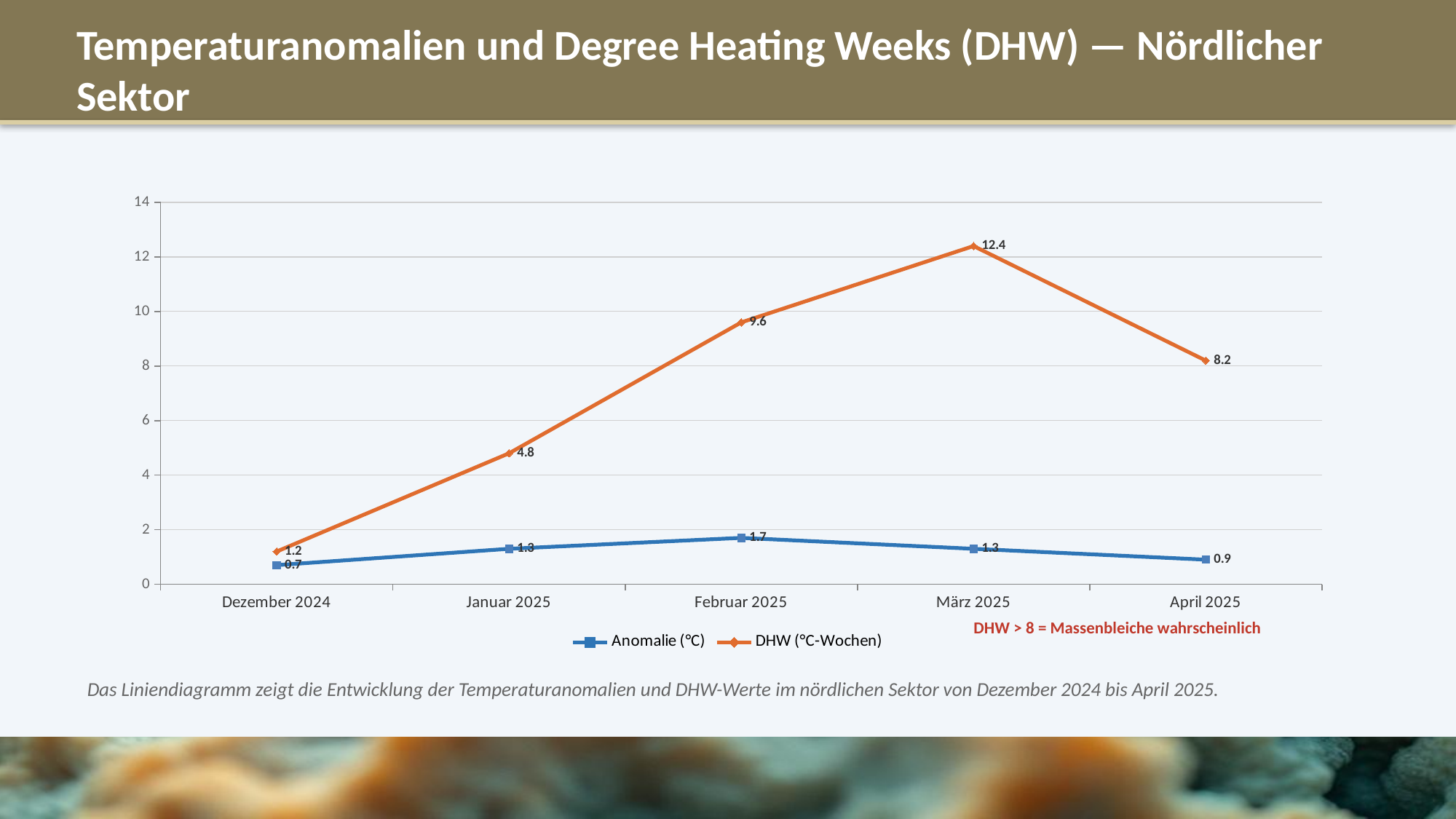
Is the DHW (°C-Wochen) value for April 2025 greater or less than 8? greater Which is larger: the DHW (°C-Wochen) value for Januar 2025 or for Februar 2025? Februar 2025 How many series does the legend list? 2 What is the DHW (°C-Wochen) value for Dezember 2024? 1.2 How many months are shown on the x axis? 5 What is the DHW (°C-Wochen) value for März 2025? 12.4 In which month is the Anomalie (°C) value lowest? Dezember 2024 What kind of chart is shown on the slide? Line chart In which month does the DHW (°C-Wochen) series reach its highest value? März 2025 Does the DHW (°C-Wochen) series rise or fall from Dezember 2024 to März 2025? Rise What is the Anomalie (°C) value for Februar 2025? 1.7 What is the difference between the DHW (°C-Wochen) values for März 2025 and April 2025? 4.2